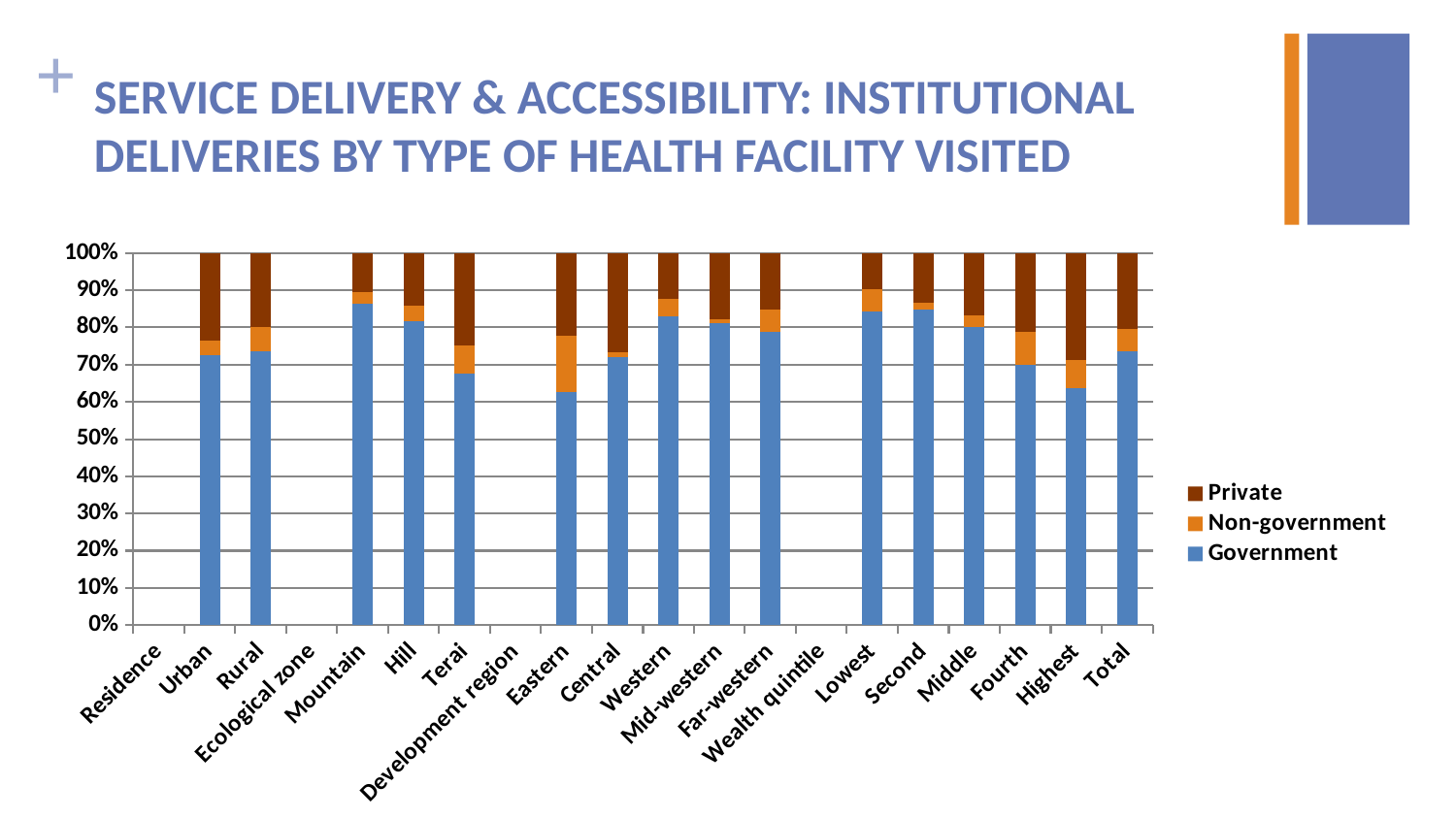
What kind of chart is shown on the slide? Stacked bar chart Which has a larger Private share, Highest or Mountain? Highest Is the Government share for Mountain greater or less than 80%? greater Is the Government share for Highest greater or less than 70%? less Which has a larger Government share, Lowest or Highest? Lowest Which colour represents the Government series? Blue Which series are listed in the legend? Private, Non-government, Government How many bars are plotted in the chart? 16 How many series does the legend list? 3 Is the Government share for Eastern greater or less than 70%? less What do the stacked segments of each bar add up to? 100%